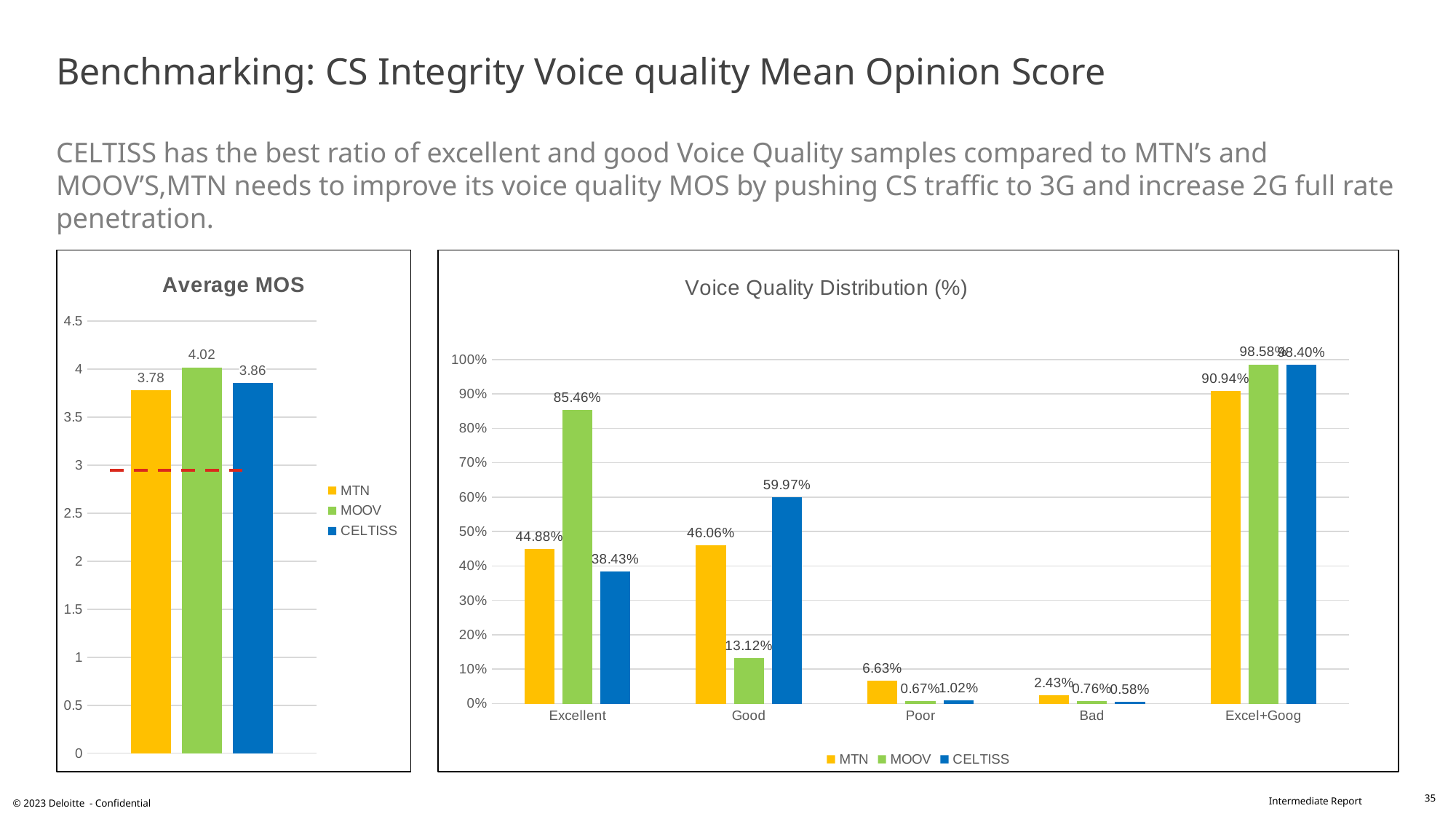
In the Voice Quality Distribution (%) chart, what is the value for MOOV in the Excellent category? 85.46% How many categories are shown on the x axis of the Voice Quality Distribution (%) chart? 5 In the Average MOS chart, what is the difference between MOOV's and MTN's values? 0.24 In the Voice Quality Distribution (%) chart, what is the difference between MTN's and MOOV's values in the Good category? 32.94% In the Voice Quality Distribution (%) chart, which is larger in the Excellent category: MTN or CELTISS? MTN In the Average MOS chart, is the value for CELTISS greater or less than 4? less In the Voice Quality Distribution (%) chart, what is the value for CELTISS in the Good category? 59.97% In the Average MOS chart, which operator has the lowest average MOS? MTN How many series does the legend of the Voice Quality Distribution (%) chart list? 3 In the Voice Quality Distribution (%) chart, which operator has the highest value in the Poor category? MTN What type of chart is the Average MOS chart? bar chart In the Average MOS chart, what is the value for MOOV? 4.02